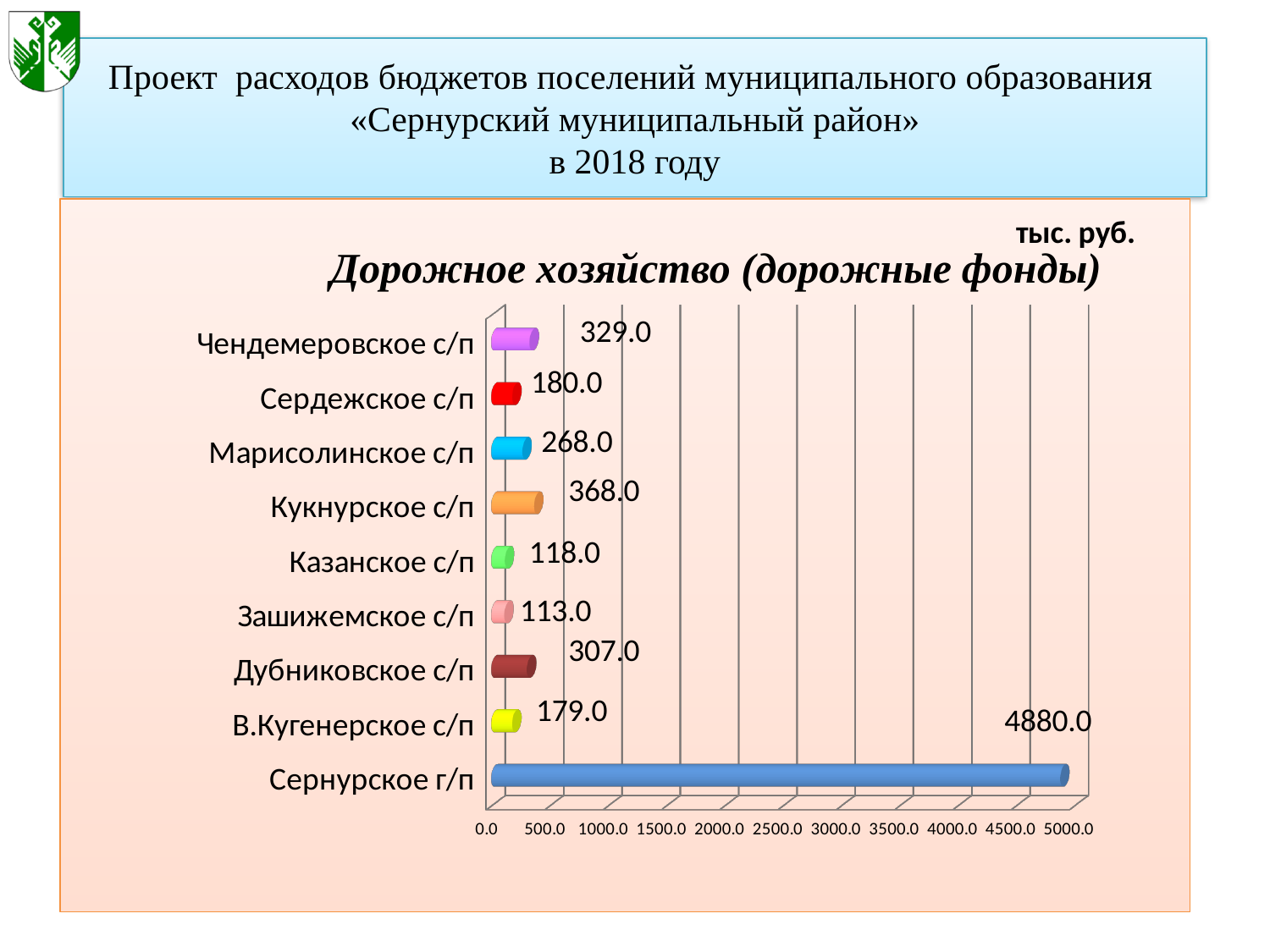
How many categories are shown in the chart? 9 What is the value for Зашижемское с/п? 113.0 Is the value for Сернурское г/п greater or less than 4500.0? greater What kind of chart is shown on the slide? bar chart What is the difference between the values for Чендемеровское с/п and Сердежское с/п? 149.0 What is the title of the chart? Дорожное хозяйство (дорожные фонды) What is the value for Сернурское г/п? 4880.0 Which is larger, the value for Дубниковское с/п or the value for В.Кугенерское с/п? Дубниковское с/п What is the value for Кукнурское с/п? 368.0 What is the value for Марисолинское с/п? 268.0 Which category has the lowest value? Зашижемское с/п Which category has the highest value? Сернурское г/п